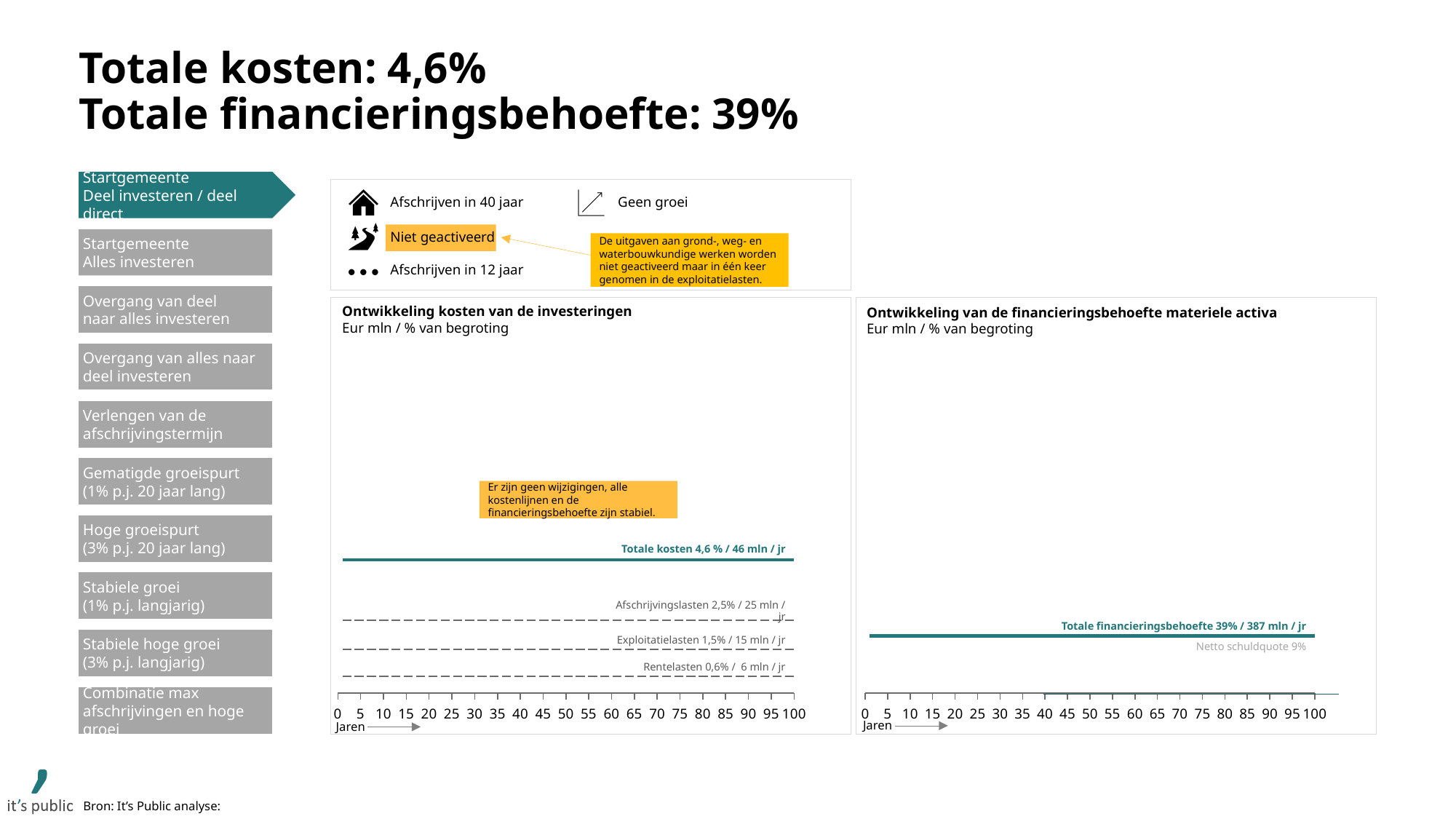
In the chart 'Ontwikkeling kosten van de investeringen', what percentage of the budget are the Exploitatielasten? 1,5% In the chart 'Ontwikkeling van de financieringsbehoefte materiele activa', what is the Totale financieringsbehoefte in mln per year? 387 mln / jr In the chart 'Ontwikkeling kosten van de investeringen', do the cost lines rise, fall or stay flat over the years? Stay flat In the chart 'Ontwikkeling kosten van de investeringen', which is larger: Exploitatielasten or Rentelasten? Exploitatielasten In the chart 'Ontwikkeling kosten van de investeringen', which cost line has the lowest value? Rentelasten What kind of chart is 'Ontwikkeling van de financieringsbehoefte materiele activa'? Line chart In the chart 'Ontwikkeling kosten van de investeringen', how many mln per year are the Afschrijvingslasten? 25 mln / jr In the chart 'Ontwikkeling kosten van de investeringen', what is the difference in mln per year between Afschrijvingslasten and Exploitatielasten? 10 mln / jr In the chart 'Ontwikkeling kosten van de investeringen', what are the Rentelasten in mln per year? 6 mln / jr In the chart 'Ontwikkeling kosten van de investeringen', how many cost lines are plotted? 4 In the chart 'Ontwikkeling kosten van de investeringen', what are the total costs (Totale kosten) as a percentage of the budget? 4,6 % In the chart 'Ontwikkeling van de financieringsbehoefte materiele activa', what is the Netto schuldquote? 9%